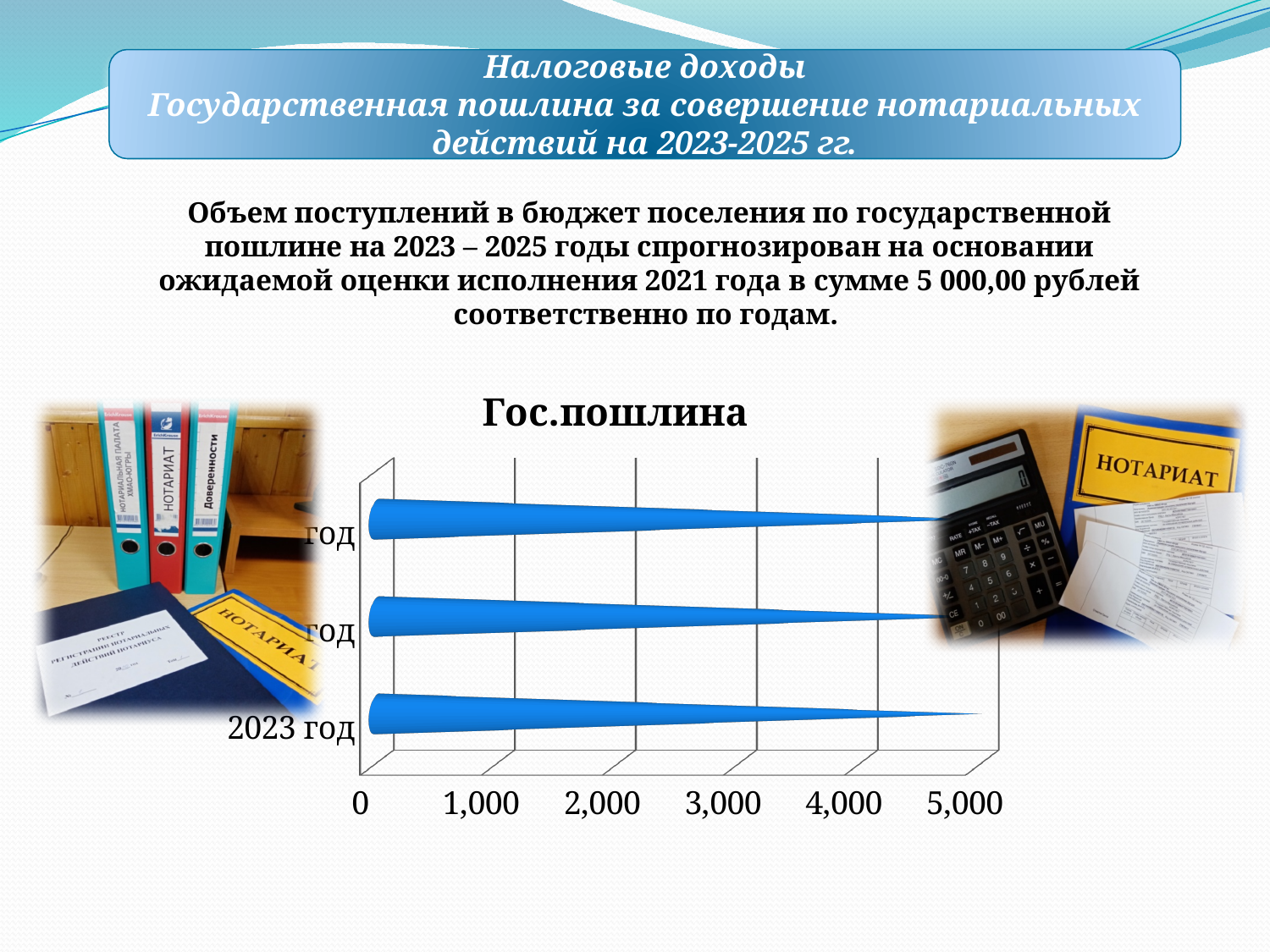
What is the title of the chart on the slide? Гос.пошлина Is the value for 2023 год in the "Гос.пошлина" chart greater or less than 3,000? greater What kind of chart is shown under the title "Гос.пошлина"? bar chart How many bars are plotted in the "Гос.пошлина" chart? 3 What value does the bar for 2023 год reach on the axis of the "Гос.пошлина" chart? 5,000 What is the highest tick value shown on the horizontal axis of the "Гос.пошлина" chart? 5,000 Is the value for 2023 год in the "Гос.пошлина" chart greater or less than 4,000? greater What is the lowest tick value shown on the horizontal axis of the "Гос.пошлина" chart? 0